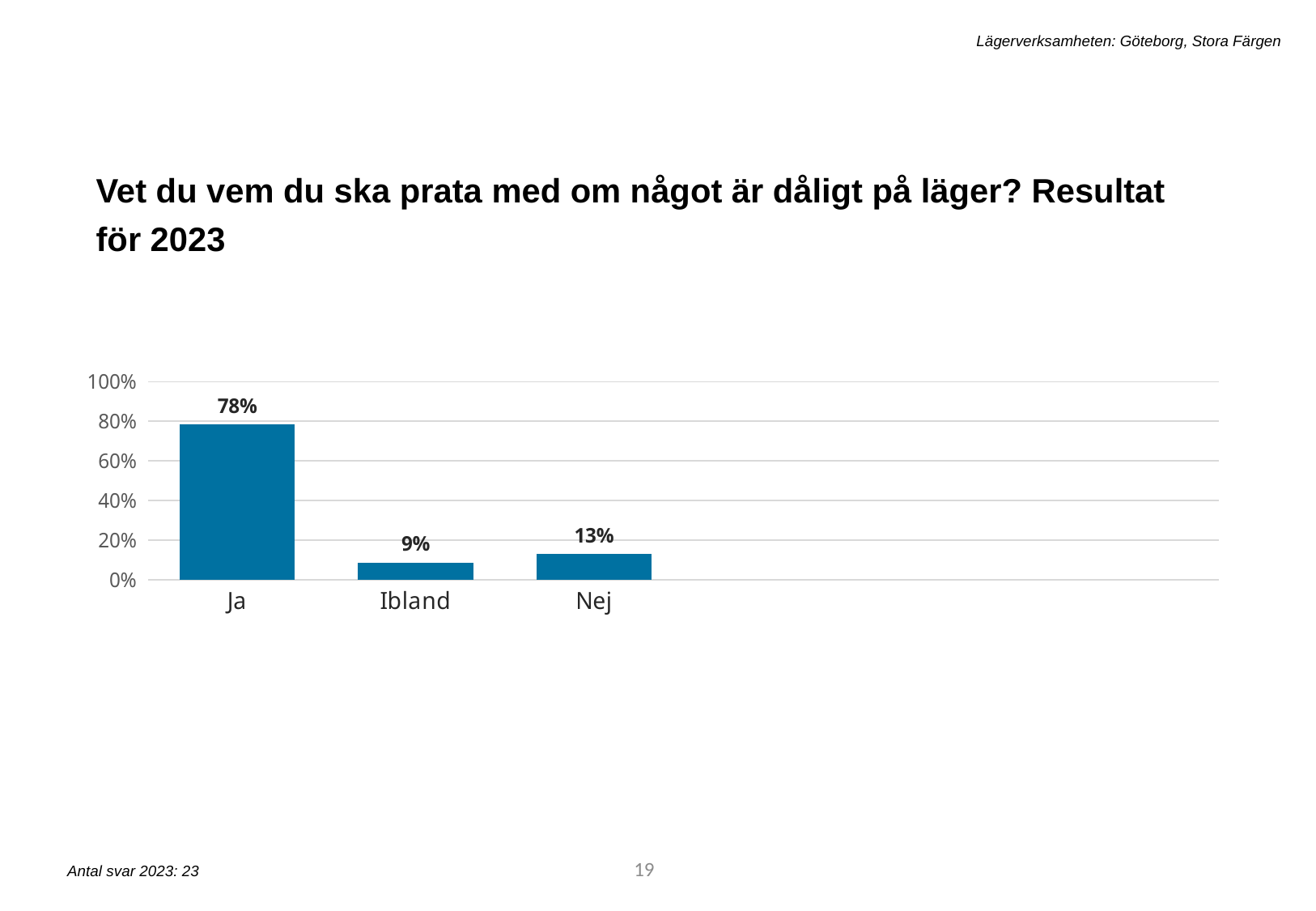
What is the difference between the values for Nej and Ibland? 4% How many categories are shown on the x axis? 3 Which is larger, the value for Ibland or the value for Nej? Nej What kind of chart is shown on the slide? bar chart What is the value for Nej? 13% What is the difference between the values for Ja and Nej? 65% What is the value for Ja? 78% Is the value for Ja greater or less than 60%? greater What is the highest value shown on the y axis? 100% Which category has the highest value? Ja What is the value for Ibland? 9% Which category has the lowest value? Ibland